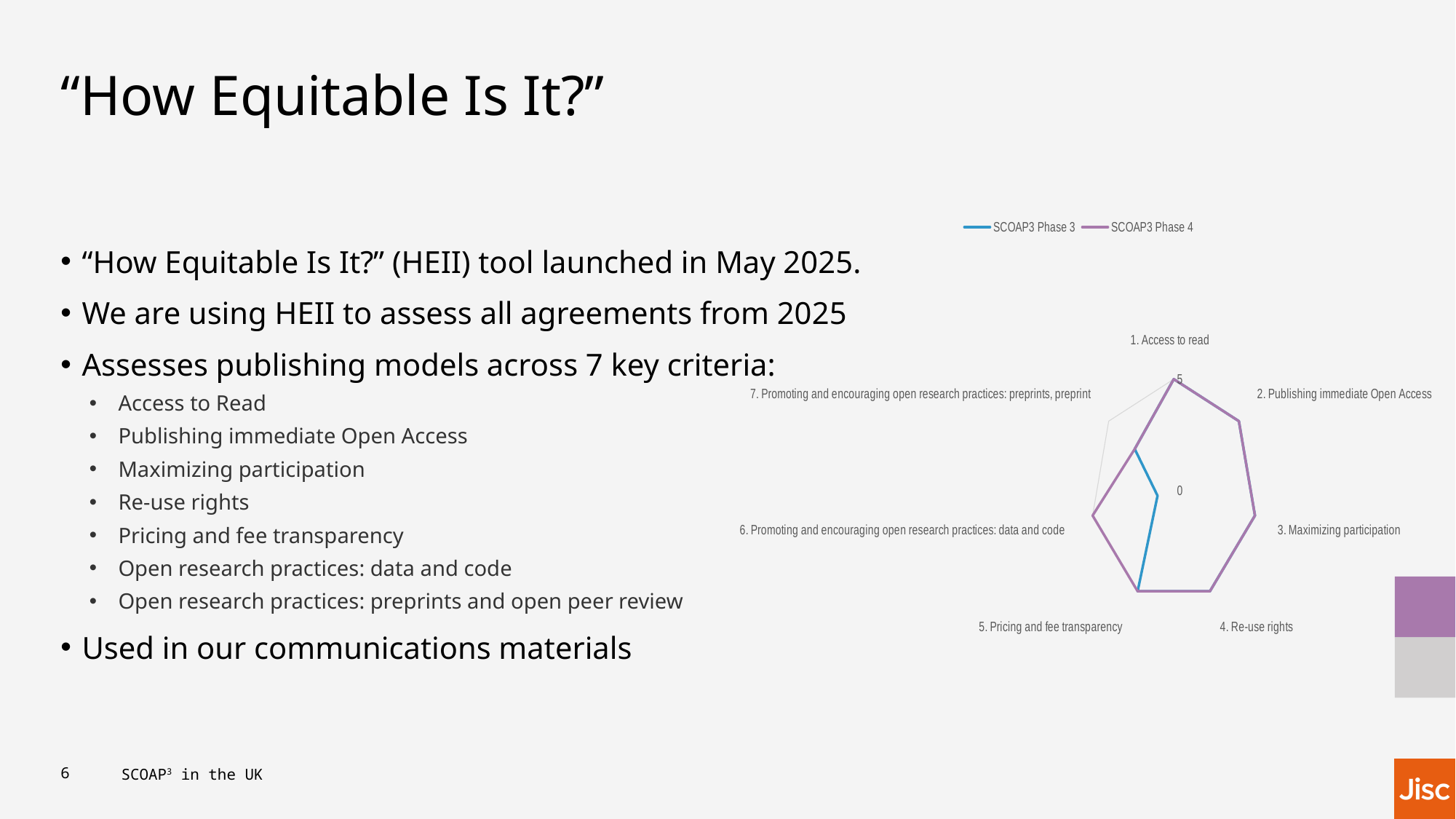
On which criterion does SCOAP3 Phase 4 have its lowest value? 7. Promoting and encouraging open research practices: preprints, preprint For '1. Access to read', which series has the larger value, SCOAP3 Phase 3 or SCOAP3 Phase 4? Neither; both series are equal (5) What are the two series named in the chart's legend? SCOAP3 Phase 3 and SCOAP3 Phase 4 How many criteria (axes) does the radar chart have? 7 How many series does the chart's legend list? 2 What is the highest value marked on the chart's axis scale? 5 What colour is the SCOAP3 Phase 4 line in the chart? Purple For '4. Re-use rights', which series scores higher? Neither; both series are equal (5) For '3. Maximizing participation', which series has the larger value? Neither; both series are equal (5) What kind of chart is shown on the slide? Radar chart